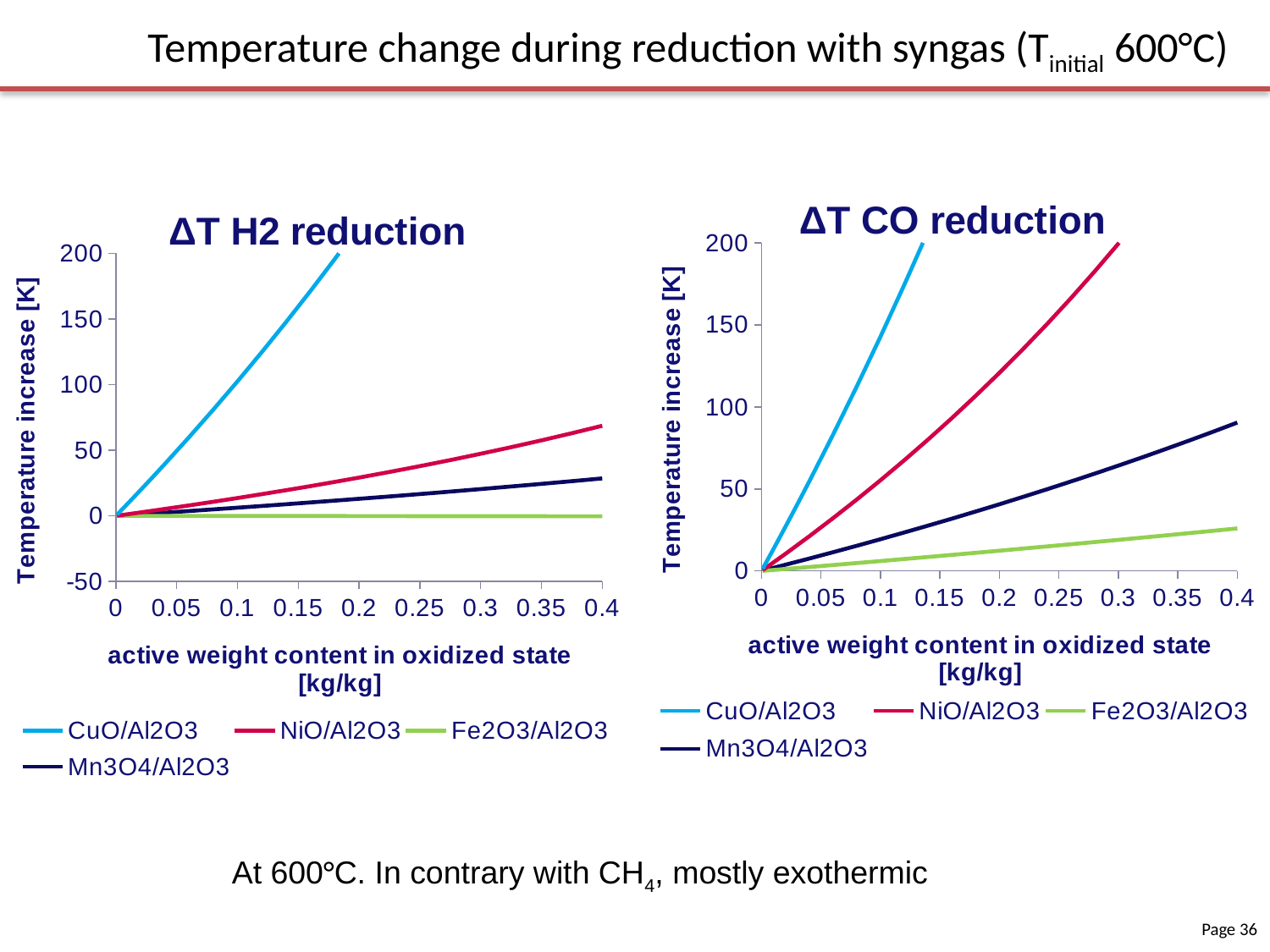
In the "ΔT CO reduction" chart, which series is larger at 0.4 kg/kg: Mn3O4/Al2O3 or Fe2O3/Al2O3? Mn3O4/Al2O3 In the "ΔT H2 reduction" chart, which series is larger at 0.4 kg/kg: NiO/Al2O3 or Mn3O4/Al2O3? NiO/Al2O3 In the "ΔT CO reduction" chart, is the value for Mn3O4/Al2O3 at 0.4 kg/kg greater or less than 50? greater What is the y-axis label of the "ΔT H2 reduction" chart? Temperature increase [K] How many series does the legend of the "ΔT CO reduction" chart list? 4 In the "ΔT CO reduction" chart, is the value for Fe2O3/Al2O3 at 0.4 kg/kg greater or less than 50? less In the "ΔT H2 reduction" chart, is the value for NiO/Al2O3 at 0.4 kg/kg greater or less than 50? greater In the "ΔT CO reduction" chart, does the NiO/Al2O3 series rise or fall as the active weight content increases? rise What is the x-axis label of the "ΔT CO reduction" chart? active weight content in oxidized state [kg/kg] What kind of chart is the "ΔT H2 reduction" chart? line chart In the "ΔT CO reduction" chart, which series rises most steeply? CuO/Al2O3